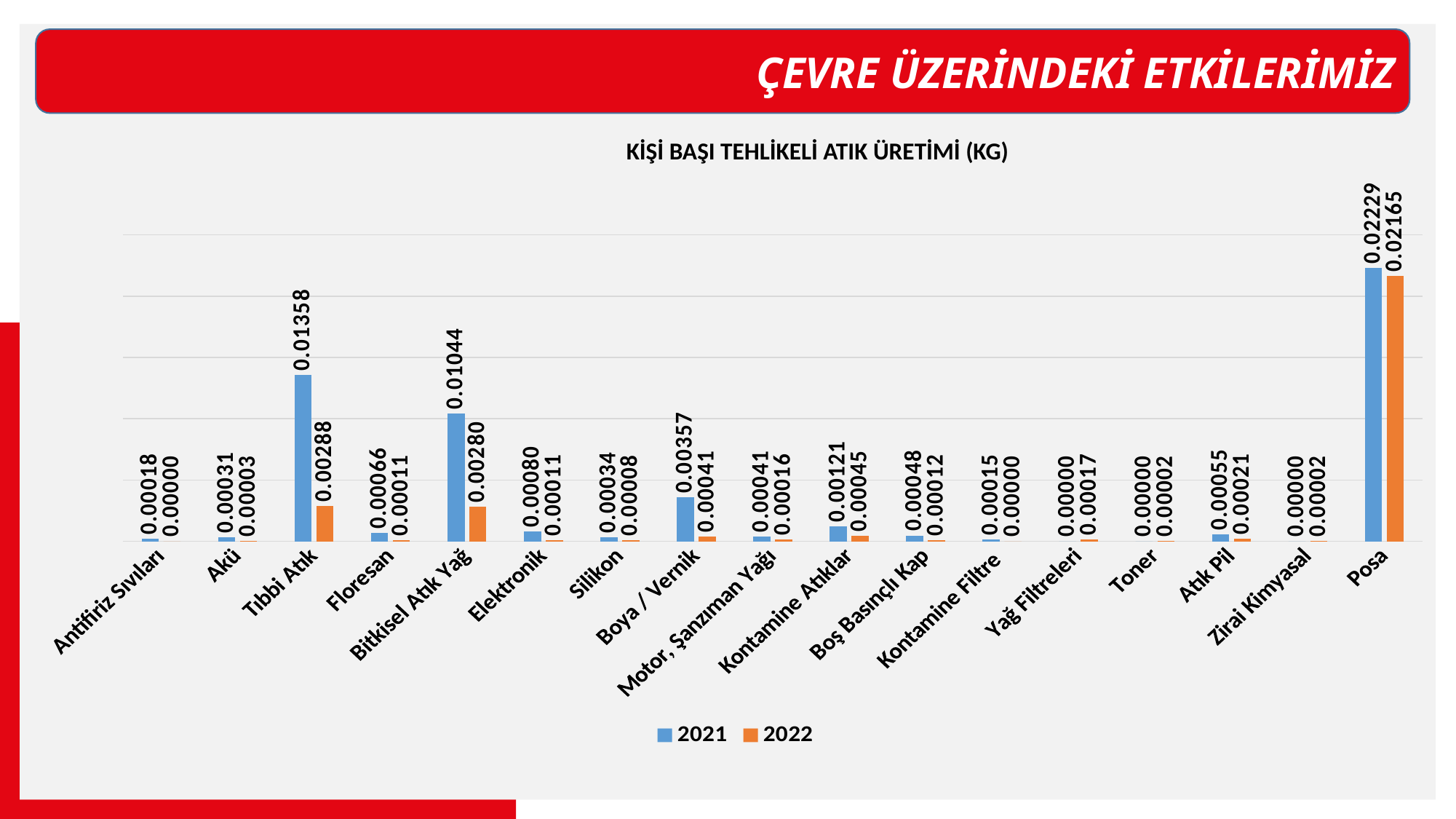
What is the 2022 value for Posa? 0.02165 Which category has the highest 2022 value? Posa How many series does the legend list? 2 What type of chart is shown on the slide? Bar chart Which category has the highest 2021 value? Posa Which is larger for Kontamine Atıklar, the 2021 value or the 2022 value? 2021 What is the 2022 value for Bitkisel Atık Yağ? 0.00280 How many categories are shown on the x axis? 17 What is the difference between the 2021 and 2022 values for Posa? 0.00064 What is the 2021 value for Tıbbi Atık? 0.01358 What is the 2021 value for Boya / Vernik? 0.00357 What is the difference between the 2021 and 2022 values for Tıbbi Atık? 0.01070